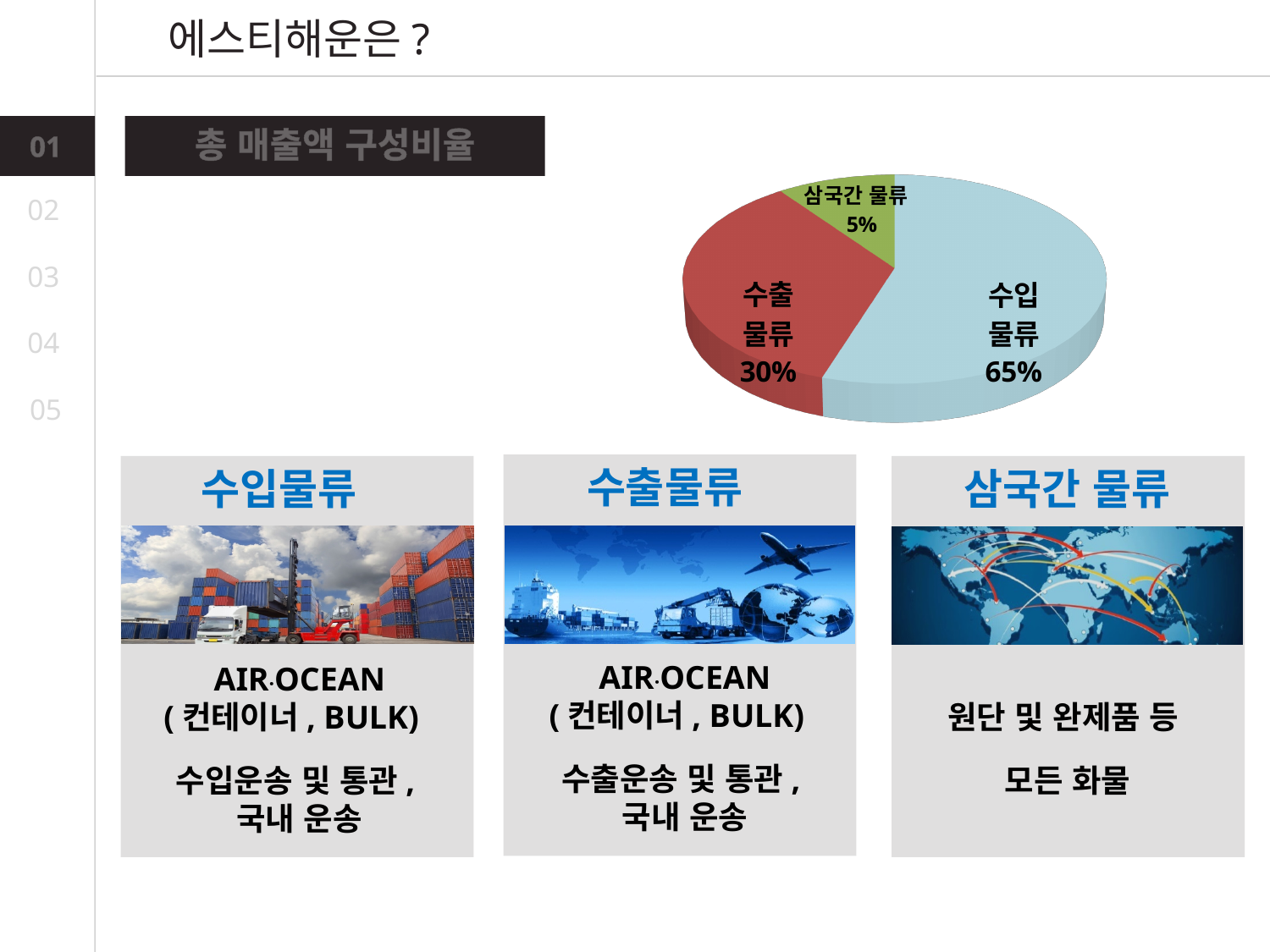
What is the difference in percentage points between 수출 물류 and 삼국간 물류? 25 What share of the pie does 수입 물류 have? 65% What is the title shown in the dark box above the pie chart? 총 매출액 구성비율 What is the difference in percentage points between 수입 물류 and 수출 물류? 35 What share of the pie does 삼국간 물류 have? 5% Which is larger, the share for 수출 물류 or the share for 삼국간 물류? 수출 물류 Which slice of the pie chart is the largest? 수입 물류 What kind of chart is shown on the slide? pie chart Which slice of the pie chart is the smallest? 삼국간 물류 What colour is the 수출 물류 slice of the pie chart? red How many slices does the pie chart have? 3 What share of the pie does 수출 물류 have? 30%